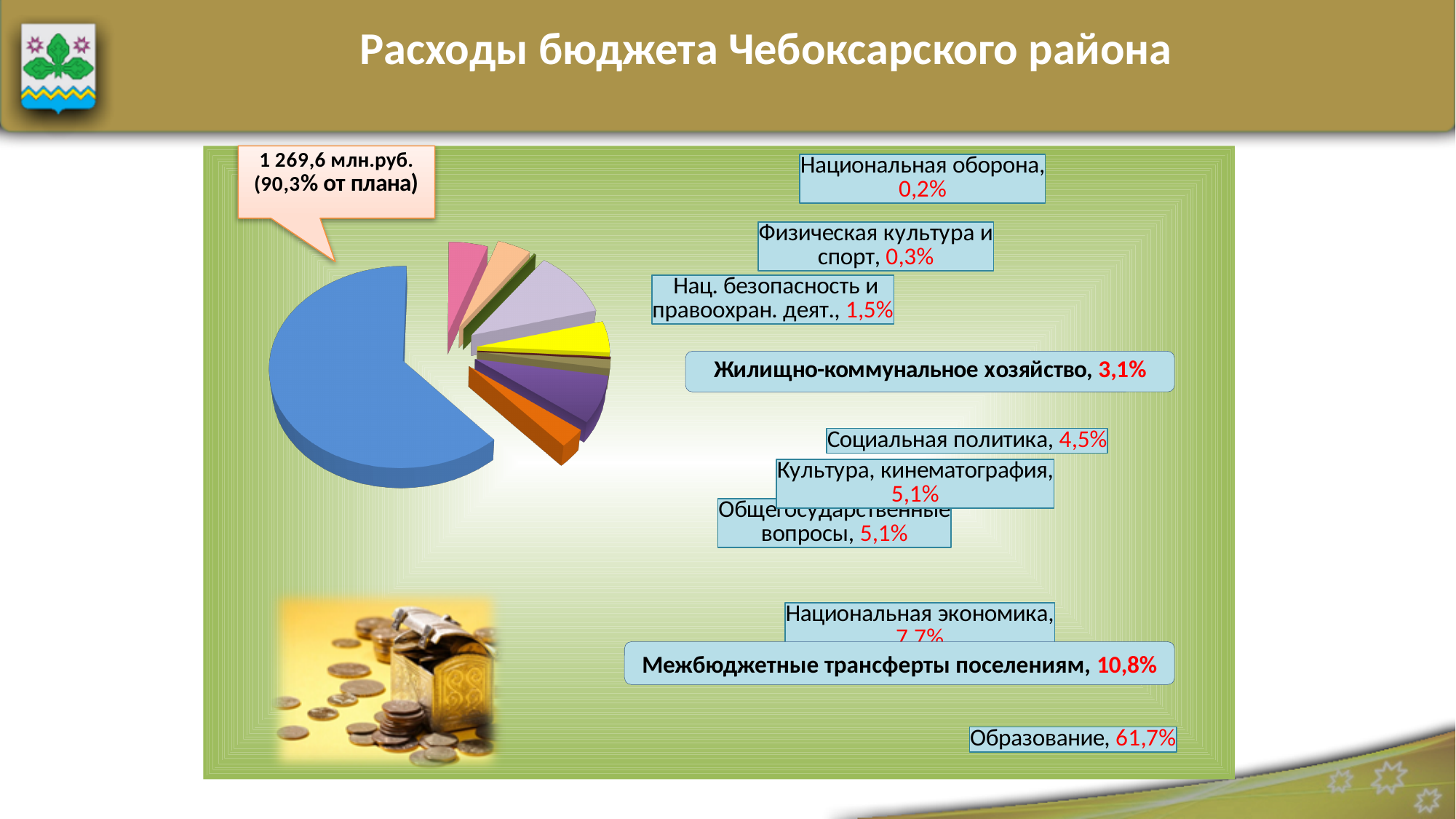
What is the value for Межбюджетные трансферты поселениям? 10,8% Which is larger: Социальная политика or Нац. безопасность и правоохран. деят.? Социальная политика What is the difference between the shares of Образование and Межбюджетные трансферты поселениям? 50,9% Which category has the largest share of expenditure? Образование What kind of chart is shown on the slide? pie chart How many expenditure categories are labelled on the slide? 10 What is the value for Национальная оборона? 0,2% What total expenditure amount is shown in the callout next to the pie chart? 1 269,6 млн.руб. (90,3% от плана) Which category has the smallest share of expenditure? Национальная оборона What is the value for Социальная политика? 4,5% What is the value for Жилищно-коммунальное хозяйство? 3,1% What share of budget expenditure goes to Образование? 61,7%